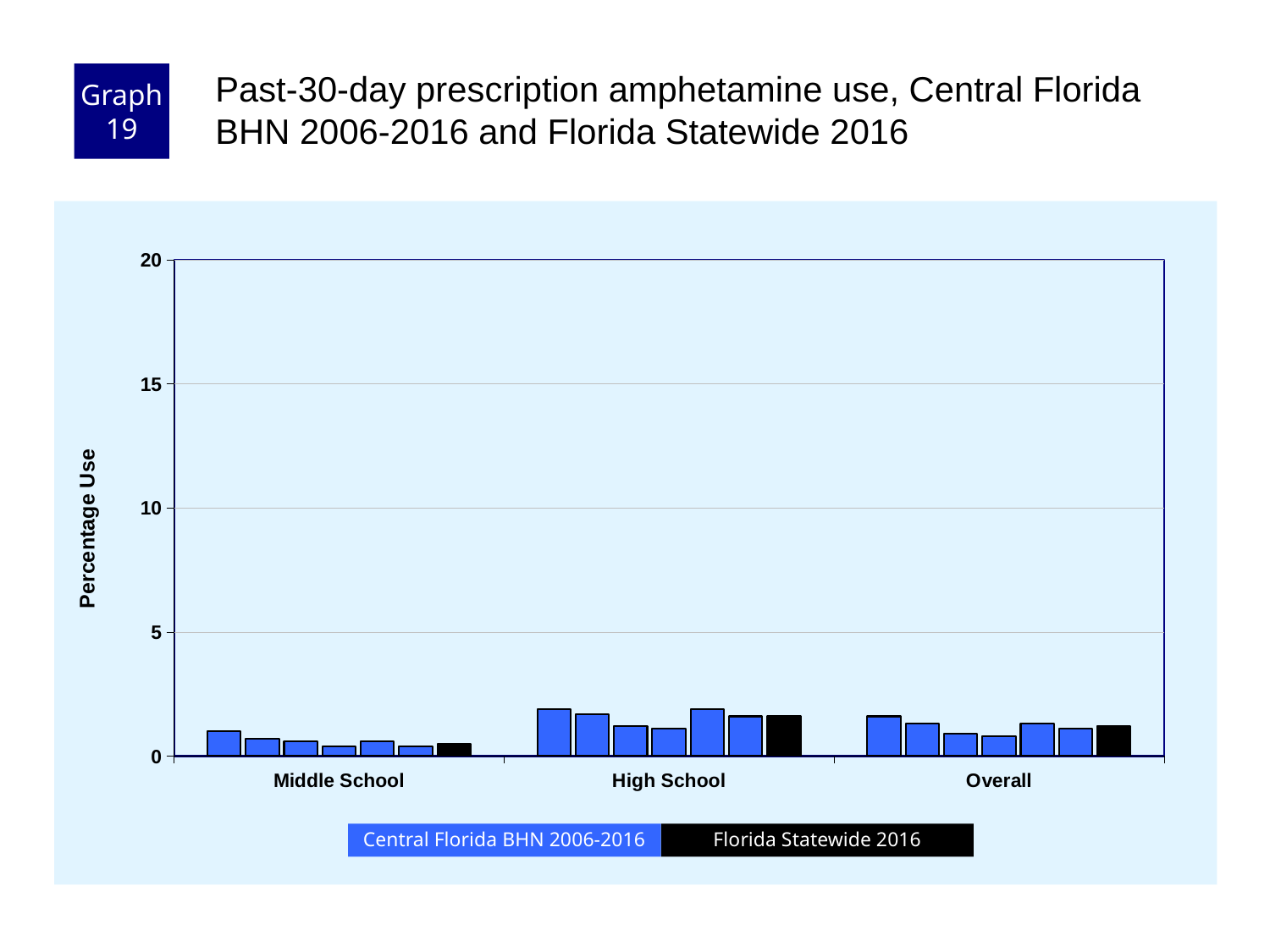
What kind of chart is shown on the slide? bar chart Is the Florida Statewide 2016 value for Overall greater or less than 5? less What is the label of the y axis? Percentage Use Which series is shown in black in the chart? Florida Statewide 2016 How many categories are shown on the x axis of the chart? 3 Which category has the lowest Florida Statewide 2016 value? Middle School Is the Florida Statewide 2016 value for Middle School greater or less than 5? less How many series does the chart's legend list? 2 Is the Florida Statewide 2016 value larger for High School or for Middle School? High School Are all the bars in the chart below the 5 tick on the y axis? Yes Which category has the highest Florida Statewide 2016 value? High School